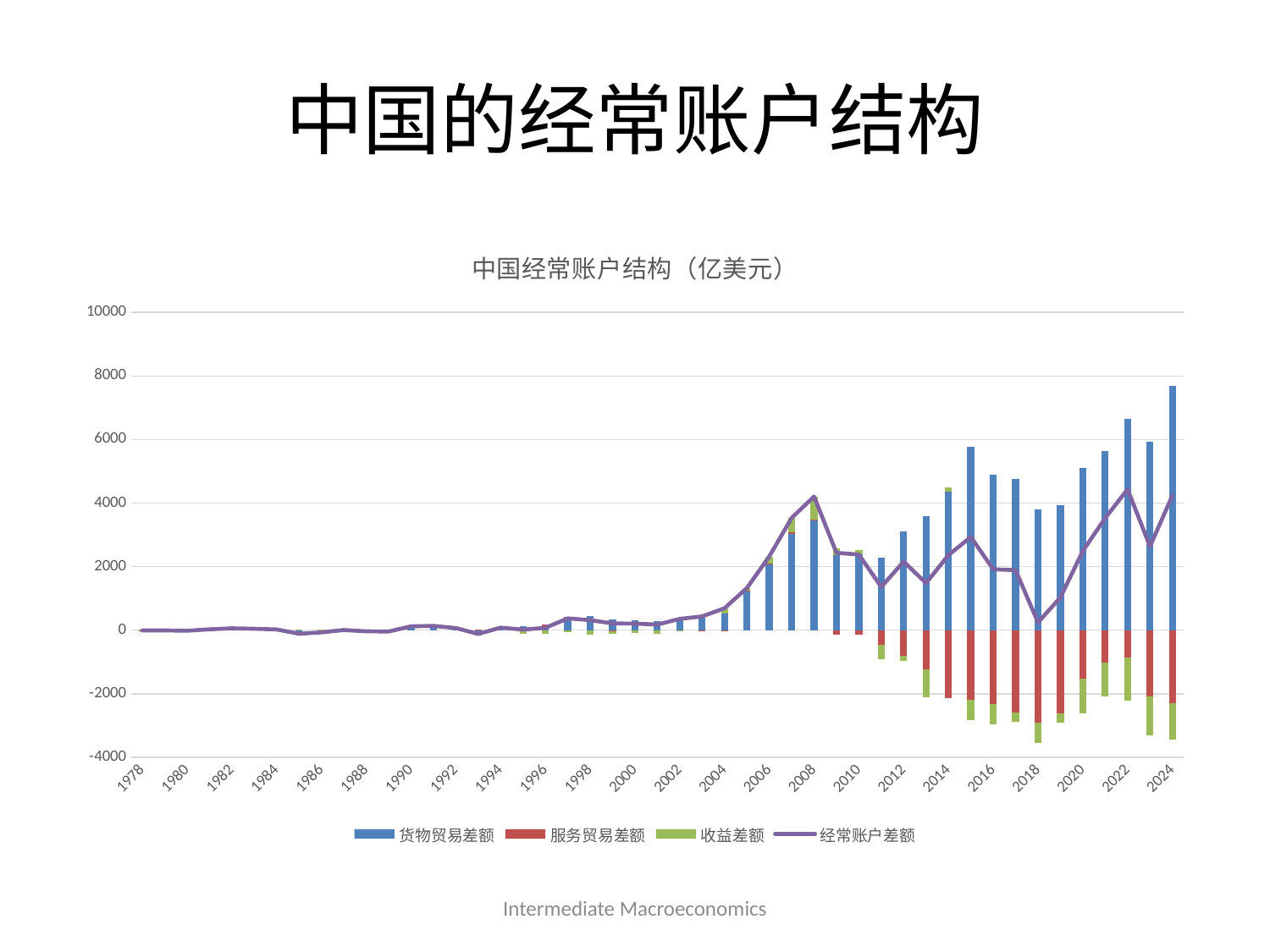
Is the value of 服务贸易差额 in 2018 greater or less than -2000? less Which is larger, the 货物贸易差额 in 2024 or in 2022? 2024 Is the value of 货物贸易差额 in 2024 greater or less than 6000? greater Does the 经常账户差额 line rise or fall from 2004 to 2008? rise Is the value of 经常账户差额 in 2018 greater or less than 1000? less How many series does the legend list? 4 Between 2010 and 2024, in which year is the 经常账户差额 line at its lowest? 2018 Which series is drawn as a line rather than bars? 经常账户差额 In which year is the 货物贸易差额 bar the tallest? 2024 What kind of chart is shown on the slide? bar chart with a line What is the title of the chart? 中国经常账户结构（亿美元）